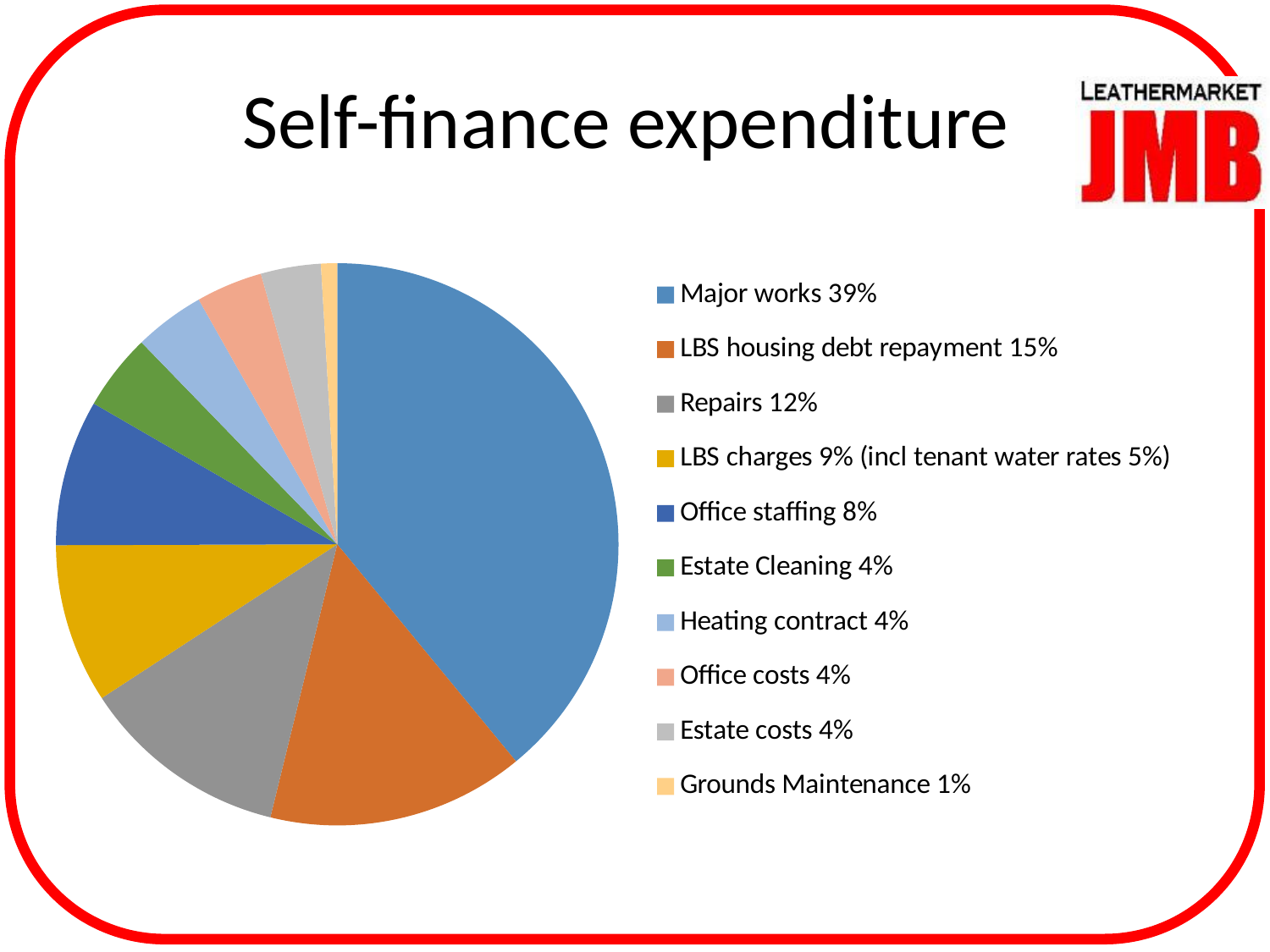
What is the title of the chart on the slide? Self-finance expenditure Which category has the smallest share of self-finance expenditure? Grounds Maintenance What kind of chart is shown on the slide? Pie chart Which category has the largest share of self-finance expenditure? Major works How many categories does the pie chart show? 10 What share of self-finance expenditure is Grounds Maintenance? 1% What share of self-finance expenditure is LBS housing debt repayment? 15% What share of self-finance expenditure is Major works? 39% Which has the larger share, Repairs or Office staffing? Repairs What is the difference in share between Major works and LBS housing debt repayment? 24%